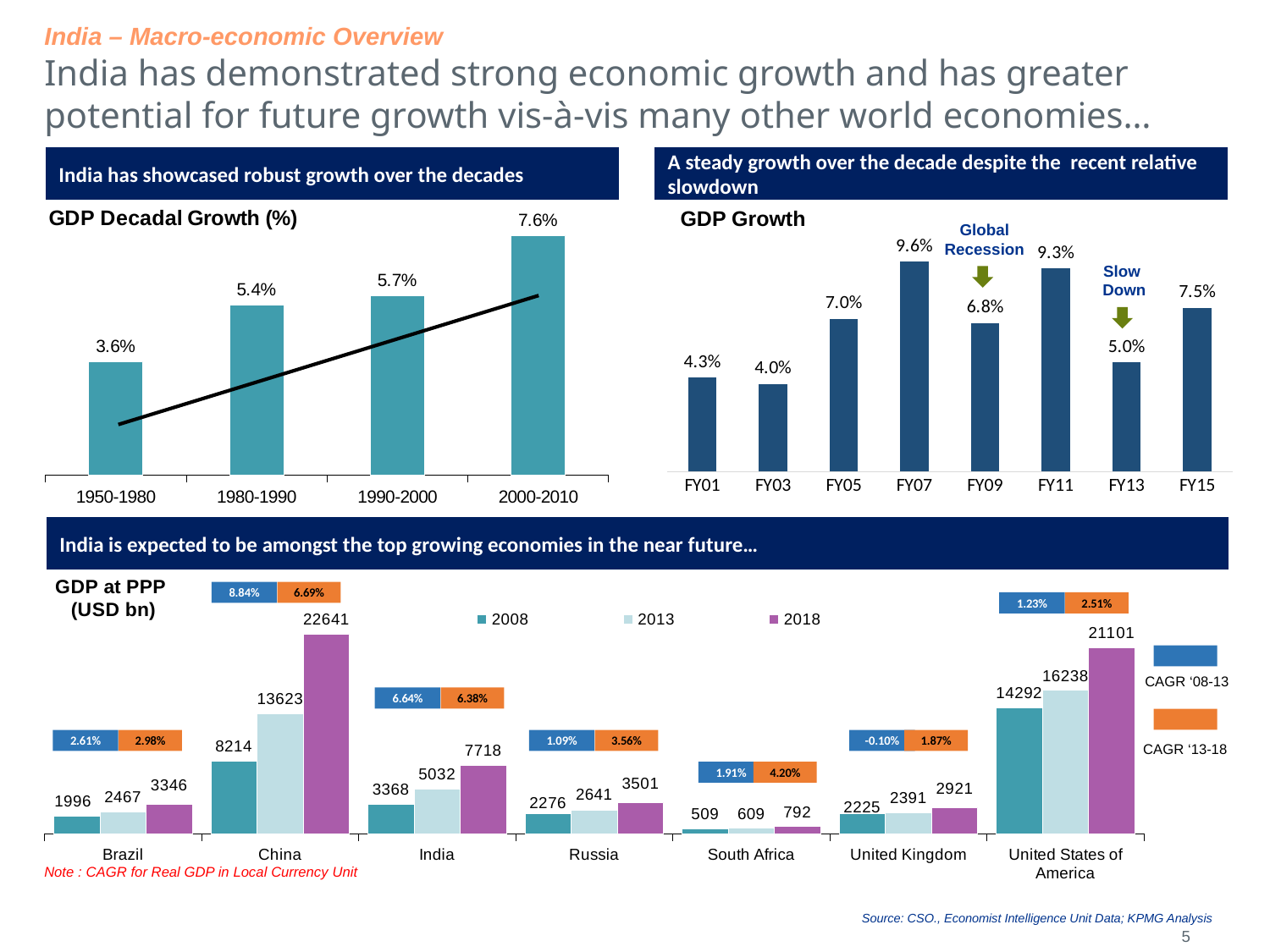
In the GDP Growth chart, what is the value for FY07? 9.6% In the GDP Decadal Growth (%) chart, how many periods are shown? 4 In the GDP at PPP (USD bn) chart, what is the 2018 value for India? 7718 What kind of chart is the GDP at PPP (USD bn) chart? Bar chart In the GDP Growth chart, which fiscal year has the lowest value? FY03 In the GDP at PPP (USD bn) chart, what is the difference between the 2013 and 2008 values for China? 5409 In the GDP Decadal Growth (%) chart, what is the value for 1990-2000? 5.7% In the GDP Growth chart, how many fiscal years are plotted? 8 In the GDP Decadal Growth (%) chart, which period has the highest value? 2000-2010 In the GDP Growth chart, which is larger, the value for FY11 or the value for FY15? FY11 In the GDP Decadal Growth (%) chart, what is the difference between the 2000-2010 value and the 1950-1980 value? 4.0% In the GDP at PPP (USD bn) chart, how many series does the legend list? 3